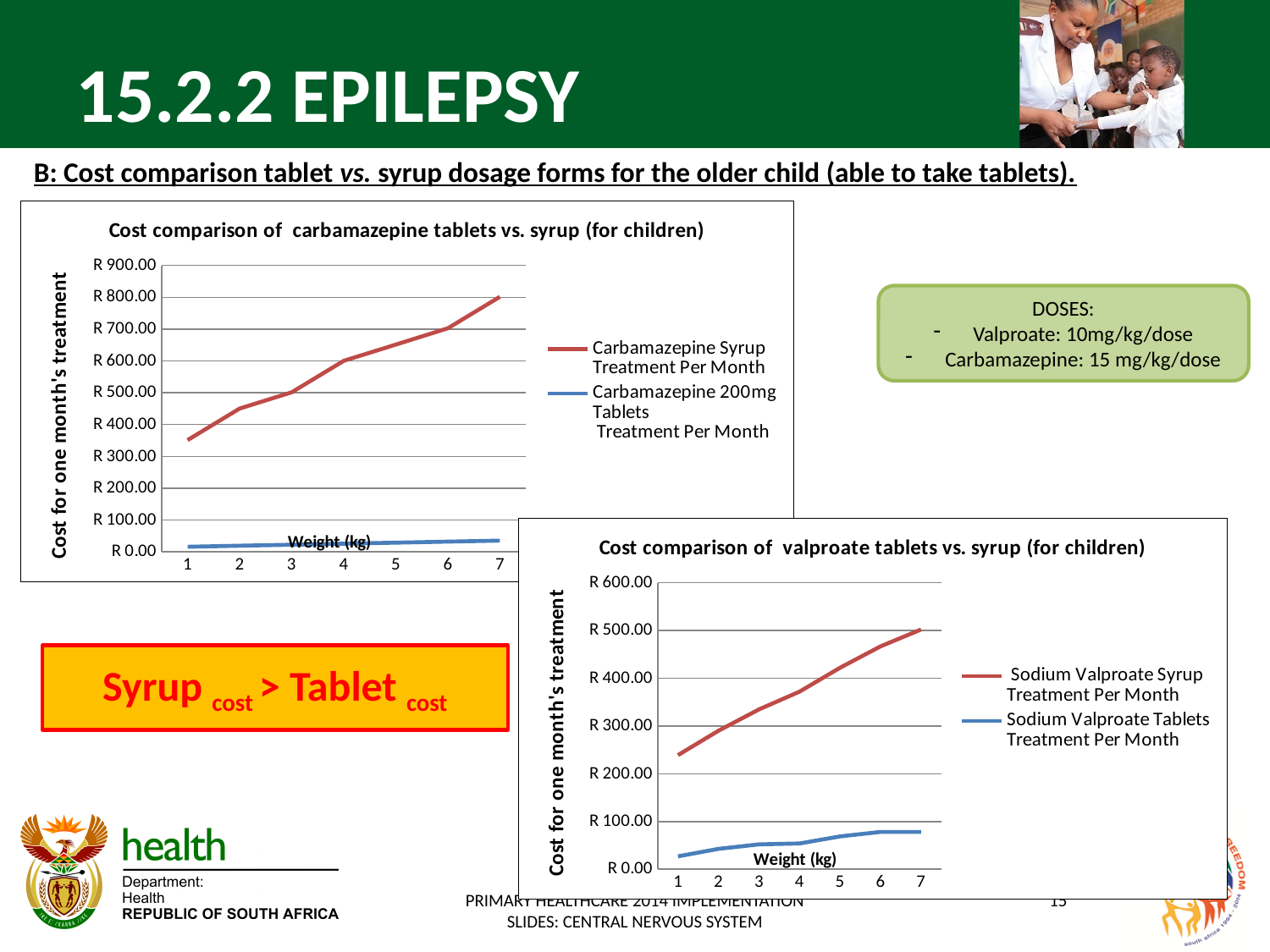
In the 'Cost comparison of carbamazepine tablets vs. syrup (for children)' chart, does the Carbamazepine Syrup Treatment Per Month line rise or fall as weight increases? rise What is the y-axis label of the 'Cost comparison of valproate tablets vs. syrup (for children)' chart? Cost for one month's treatment How many series does the legend of the 'Cost comparison of valproate tablets vs. syrup (for children)' chart list? 2 How many series does the legend of the 'Cost comparison of carbamazepine tablets vs. syrup (for children)' chart list? 2 In the 'Cost comparison of valproate tablets vs. syrup (for children)' chart, which series has the highest values across all weights? Sodium Valproate Syrup Treatment Per Month In the 'Cost comparison of carbamazepine tablets vs. syrup (for children)' chart, is the Carbamazepine Syrup Treatment Per Month value at weight 7 greater or less than R 700.00? greater In the 'Cost comparison of carbamazepine tablets vs. syrup (for children)' chart, is the Carbamazepine Syrup Treatment Per Month value at weight 1 greater or less than R 400.00? less In the 'Cost comparison of valproate tablets vs. syrup (for children)' chart, is the Sodium Valproate Syrup Treatment Per Month value at weight 7 greater or less than R 400.00? greater What kind of chart is the 'Cost comparison of carbamazepine tablets vs. syrup (for children)' chart? line chart How many weight categories are shown on the x axis of the 'Cost comparison of valproate tablets vs. syrup (for children)' chart? 7 In the 'Cost comparison of carbamazepine tablets vs. syrup (for children)' chart, which series has the higher value at weight 7: Carbamazepine Syrup Treatment Per Month or Carbamazepine 200mg Tablets Treatment Per Month? Carbamazepine Syrup Treatment Per Month